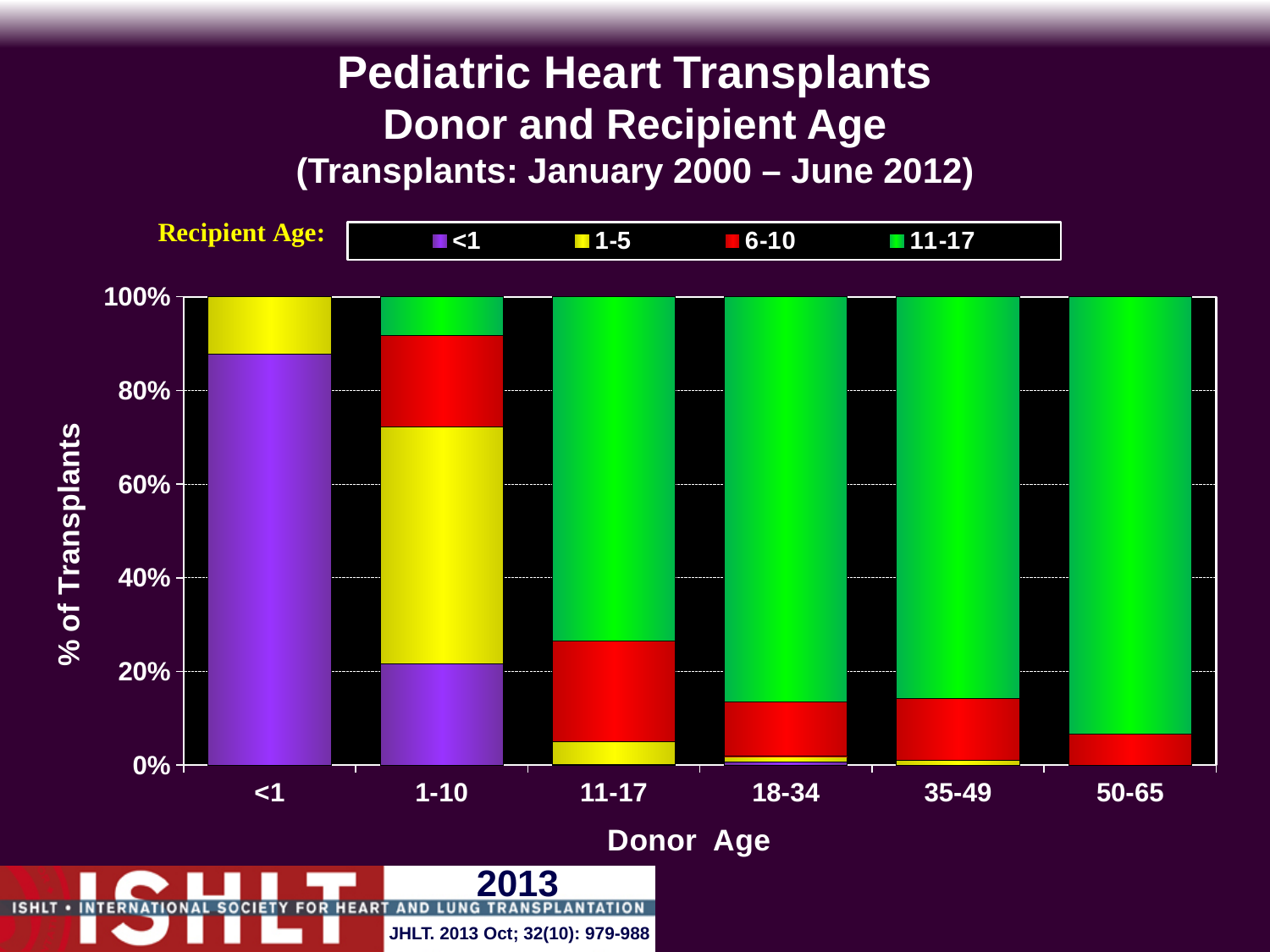
For donor age 1-10, is the share of recipients aged 1-5 greater or less than 40%? greater For donor age <1, which recipient age group has the larger share: <1 or 1-5? <1 For donor age <1, is the share of recipients aged <1 greater or less than 80%? greater Which recipient age group is shown in green in the legend? 11-17 How many recipient age groups does the legend list? 4 For donor age 50-65, is the share of recipients aged 11-17 greater or less than 80%? greater What kind of chart is shown on the slide? stacked bar chart How many donor age categories are shown on the x axis? 6 What is the total height of each stacked bar on the y axis? 100% What is the label of the y axis? % of Transplants Which donor age category has the largest share of recipients aged 11-17? 50-65